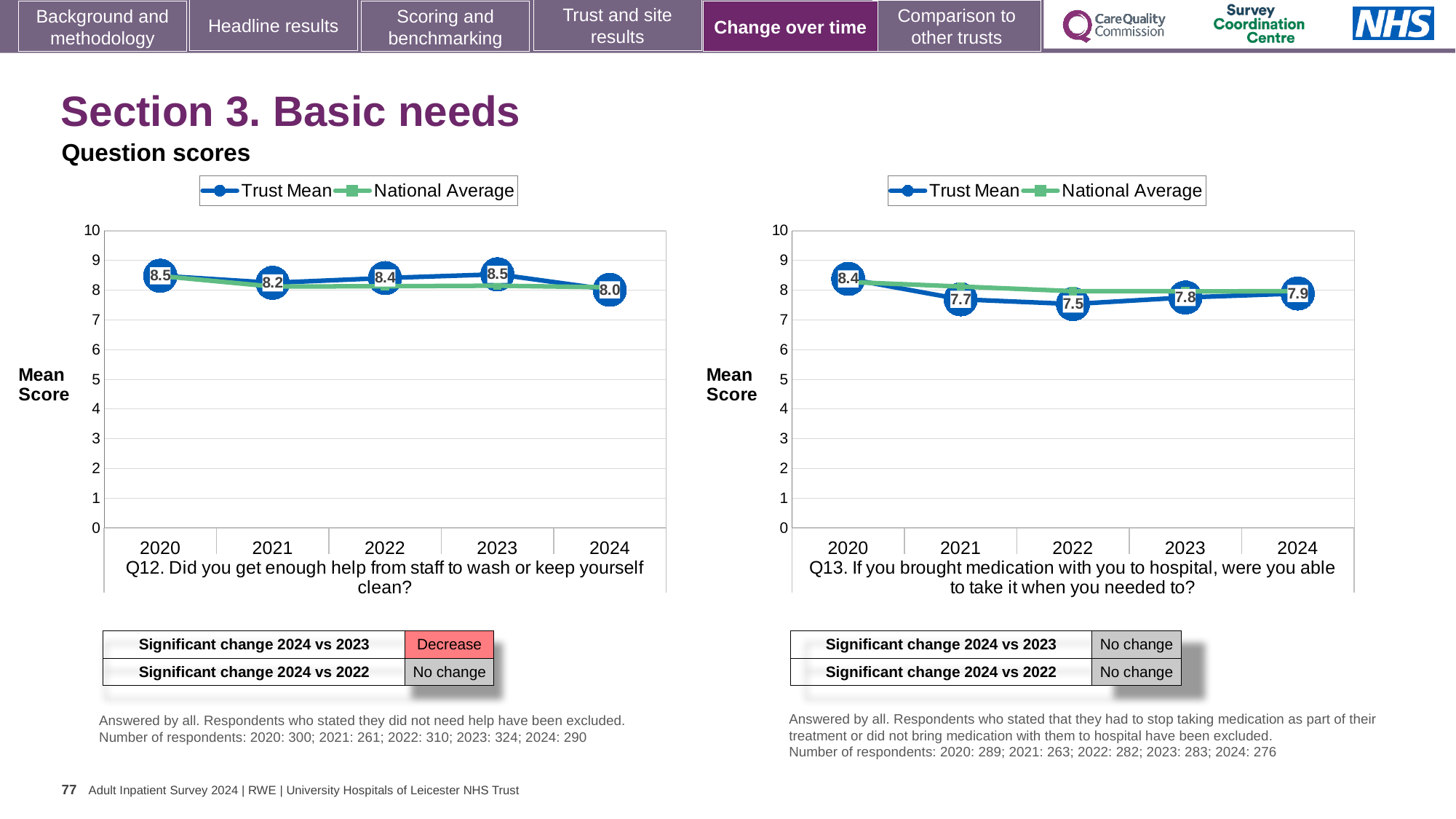
In the Q13 chart (right), is the Trust Mean score for 2021 higher or lower than for 2024? lower In the Q13 chart (right), what is the Trust Mean score for 2020? 8.4 In the Q12 chart (left), which year has the lowest Trust Mean score? 2024 In the Q13 chart (right), which year has the lowest Trust Mean score? 2022 In the Q12 chart (left), what is the difference between the Trust Mean scores for 2023 and 2024? 0.5 What type of chart is used for Q12 (left)? Line chart How many series does the legend of the Q13 chart (right) list? 2 In the Q12 chart (left), what is the Trust Mean score for 2021? 8.2 In the Q13 chart (right), what is the Trust Mean score for 2022? 7.5 In the Q12 chart (left), what is the Trust Mean score for 2024? 8.0 In the Q13 chart (right), what is the difference between the Trust Mean scores for 2020 and 2022? 0.9 How many years are shown on the x axis of the Q12 chart (left)? 5